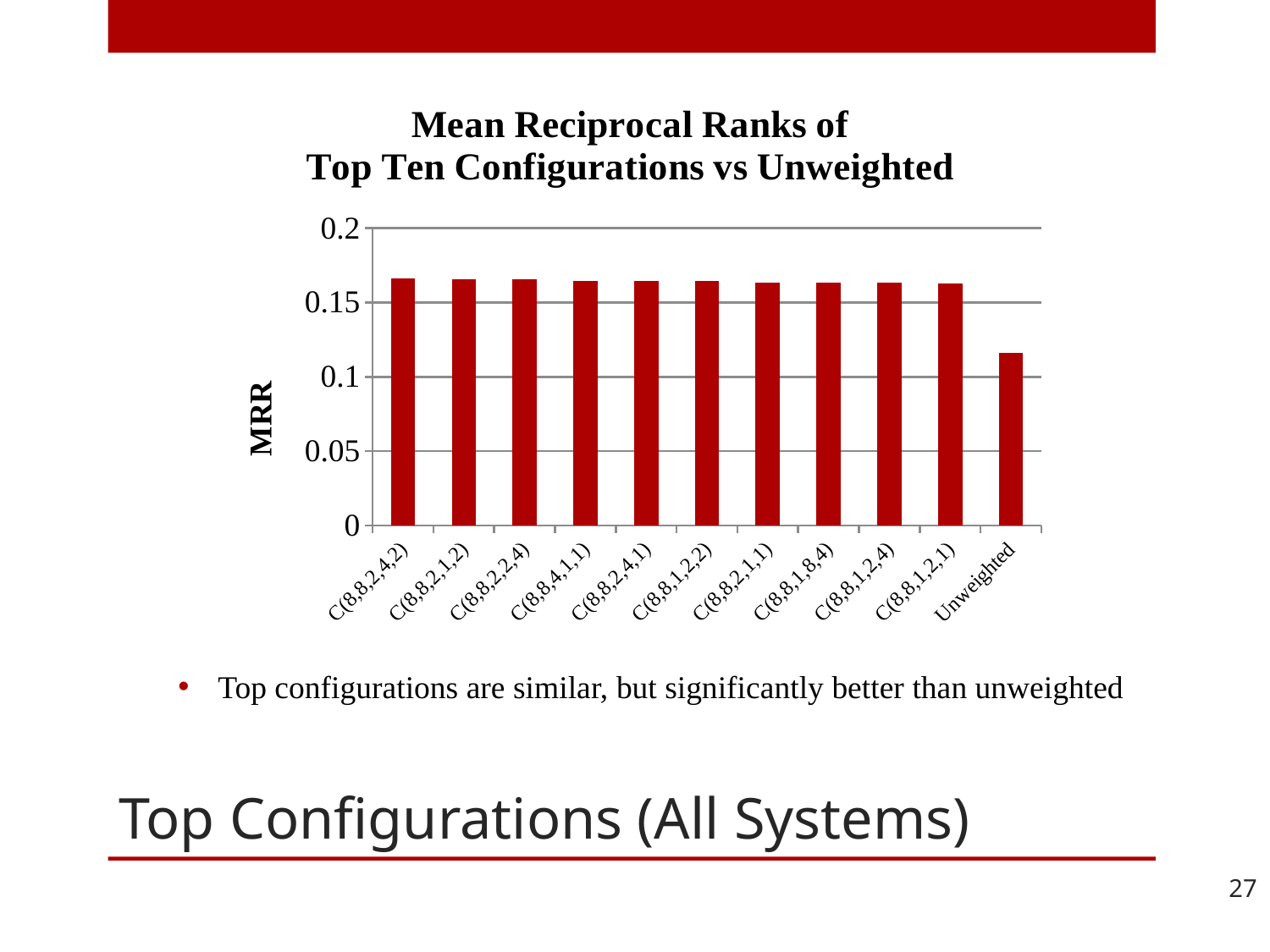
Which category has the lowest MRR in the chart? Unweighted Which category is plotted last (rightmost) on the x axis? Unweighted Is the MRR value for Unweighted greater or less than 0.15? less Is the MRR value for Unweighted greater or less than 0.1? greater Is the MRR value for C(8,8,2,4,2) greater or less than 0.15? greater What is the label on the vertical axis of the chart? MRR Which has a higher MRR, C(8,8,2,4,2) or Unweighted? C(8,8,2,4,2) How many bars are plotted in the chart? 11 What kind of chart is shown on the slide? bar chart Which has a higher MRR, Unweighted or C(8,8,1,8,4)? C(8,8,1,8,4) What is the title of the chart? Mean Reciprocal Ranks of Top Ten Configurations vs Unweighted